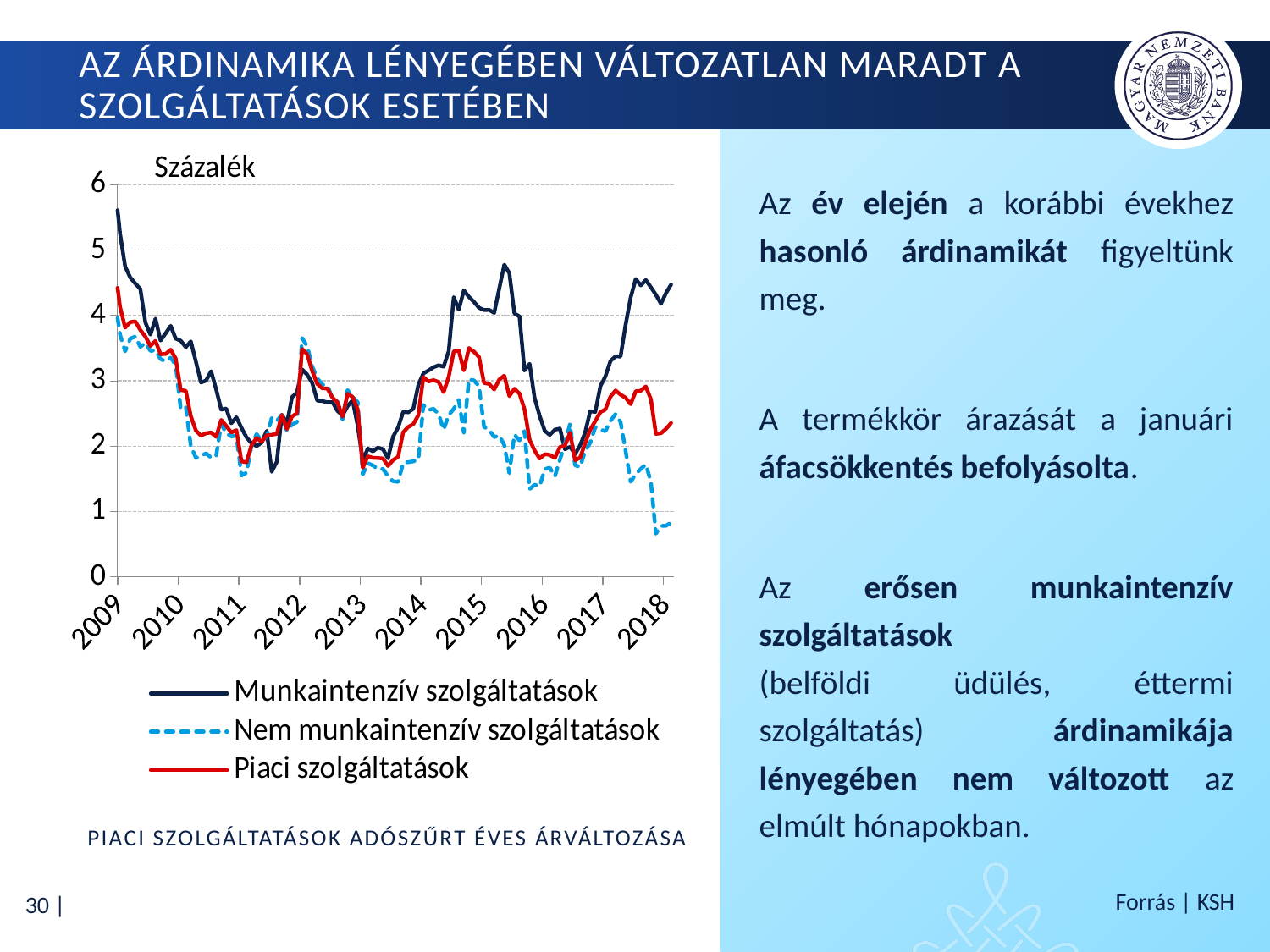
Which series reaches the highest value anywhere on the chart? Munkaintenzív szolgáltatások Is the value for Piaci szolgáltatások at the start of 2009 greater or less than 4? greater Does the Nem munkaintenzív szolgáltatások series rise or fall between 2017 and 2018? fall What unit is shown on the vertical axis of the chart? Százalék Which series reaches the lowest value anywhere on the chart? Nem munkaintenzív szolgáltatások Is the value for Nem munkaintenzív szolgáltatások at the end of the series in 2018 greater or less than 1? less How many year labels are shown on the x axis? 10 What kind of chart is shown on the slide? line chart How many series does the legend list? 3 What is the title printed below the chart? PIACI SZOLGÁLTATÁSOK ADÓSZŰRT ÉVES ÁRVÁLTOZÁSA At the end of the series in 2018, which is higher: Munkaintenzív szolgáltatások or Nem munkaintenzív szolgáltatások? Munkaintenzív szolgáltatások Is the value for Munkaintenzív szolgáltatások at the start of 2009 greater or less than 5? greater